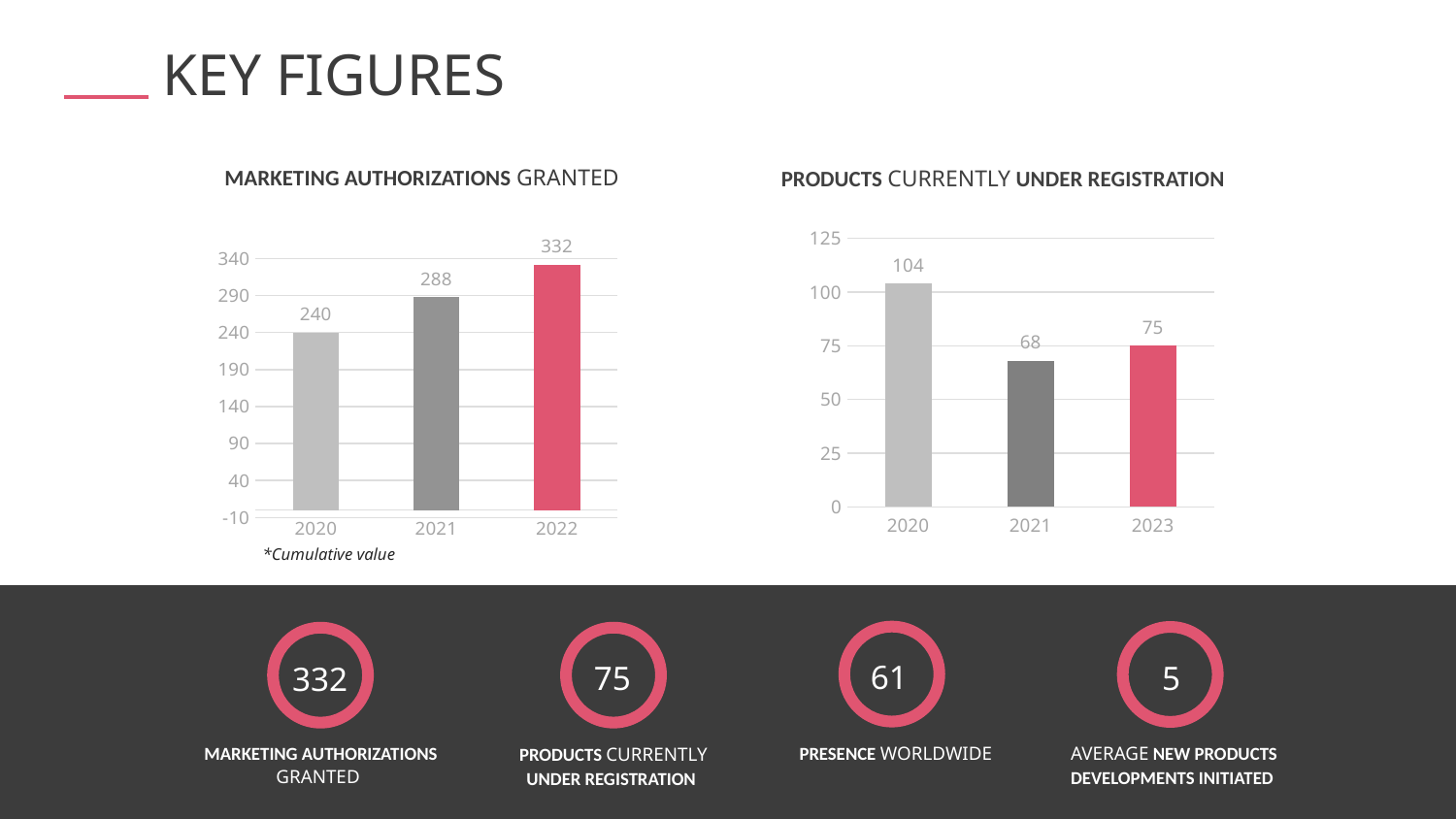
In the 'Products Currently Under Registration' chart, which year has the lowest value? 2021 In the 'Marketing Authorizations Granted' chart, which year has the highest value? 2022 In the 'Products Currently Under Registration' chart, is the value for 2020 greater or less than 100? greater In the 'Products Currently Under Registration' chart, which is larger, the value for 2021 or the value for 2023? 2023 In the 'Marketing Authorizations Granted' chart, what is the difference between the 2022 and 2020 values? 92 What kind of chart is the 'Products Currently Under Registration' chart? bar chart In the 'Products Currently Under Registration' chart, what is the difference between the 2020 and 2021 values? 36 In the 'Products Currently Under Registration' chart, what is the value for 2020? 104 In the 'Marketing Authorizations Granted' chart, how many years are shown on the x axis? 3 In the 'Marketing Authorizations Granted' chart, what is the value for 2021? 288 In the 'Marketing Authorizations Granted' chart, do the values rise or fall from 2020 to 2022? rise What note appears below the 'Marketing Authorizations Granted' chart? *Cumulative value